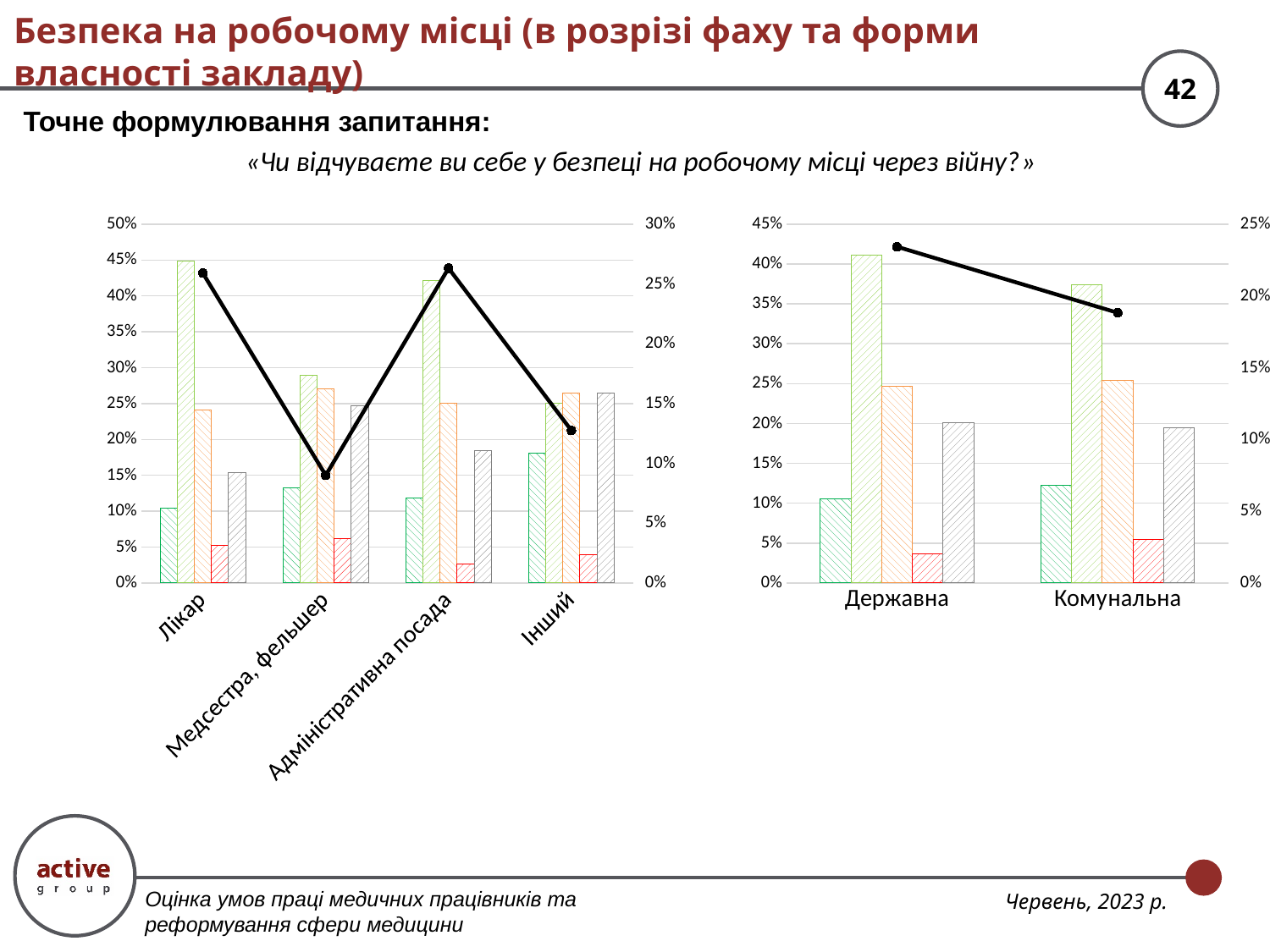
On the left chart, how many categories are shown on the x axis? 4 On the left chart, which has the larger line value: Лікар or Медсестра, фельшер? Лікар On the left chart, is the line value for Лікар greater or less than 20% on the right axis? greater On the right chart, how many categories are shown on the x axis? 2 On the left chart, is the line value for Медсестра, фельшер greater or less than 15% on the right axis? less On the right chart, which category has the taller tallest bar: Державна or Комунальна? Державна What kind of chart is the right chart? bar chart with a line On the right chart, is the line value for Державна greater or less than 20% on the right axis? greater On the left chart, which category has the lowest line value? Медсестра, фельшер On the right chart, does the line rise or fall from Державна to Комунальна? falls